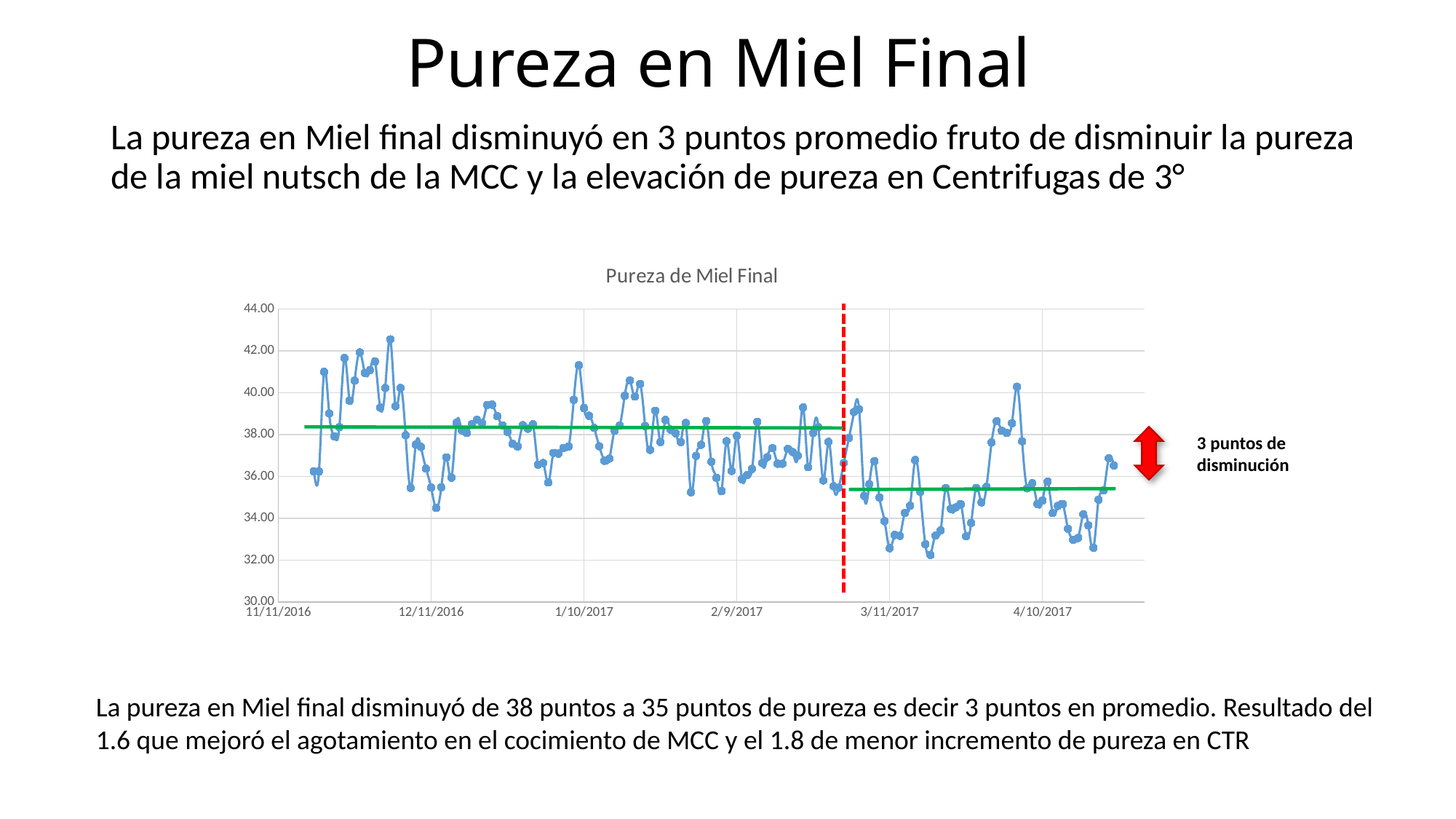
Is the green average line to the right of the red dashed line greater or less than 36.00? less Overall, do the plotted values rise or fall from left to right across the chart? Fall How many date labels are shown on the x axis of the chart? 6 What does the annotation next to the red arrow on the right of the chart say? 3 puntos de disminución Is the lowest plotted value on the chart greater or less than 34.00? less Is the green average line to the left of the red dashed line greater or less than 38.00? greater What kind of chart is shown on the slide? Line chart What is the highest value shown on the chart's y axis? 44.00 How many data series are plotted on the chart? 1 What is the title of the chart? Pureza de Miel Final Which green average line is higher: the one before the red dashed line or the one after it? The one before the red dashed line